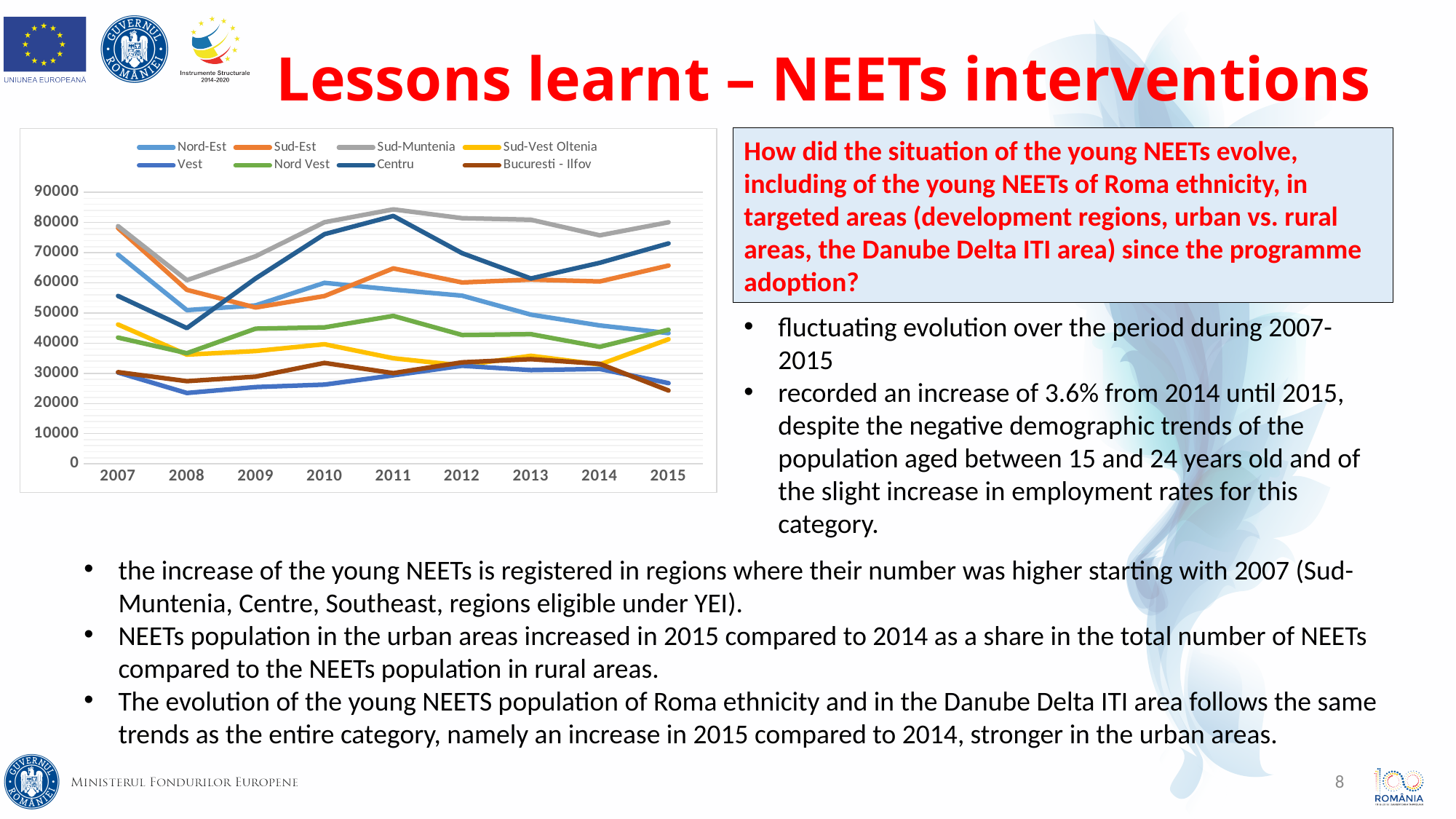
Is the value for Sud-Muntenia in 2011 greater or less than 80000? greater Is the value for Vest in 2008 greater or less than 30000? less What kind of chart is shown on the slide? line chart How many series does the chart's legend list? 8 Which region has the highest value in 2015? Sud-Muntenia Is the value for Nord-Est in 2007 greater or less than 60000? greater Does the Nord-Est line rise or fall from 2010 to 2015? fall In 2011, which is larger: the value for Centru or the value for Sud-Est? Centru What is the first year shown on the x axis of the chart? 2007 Which region has the lowest value in 2008? Vest How many years are shown along the x axis of the chart? 9